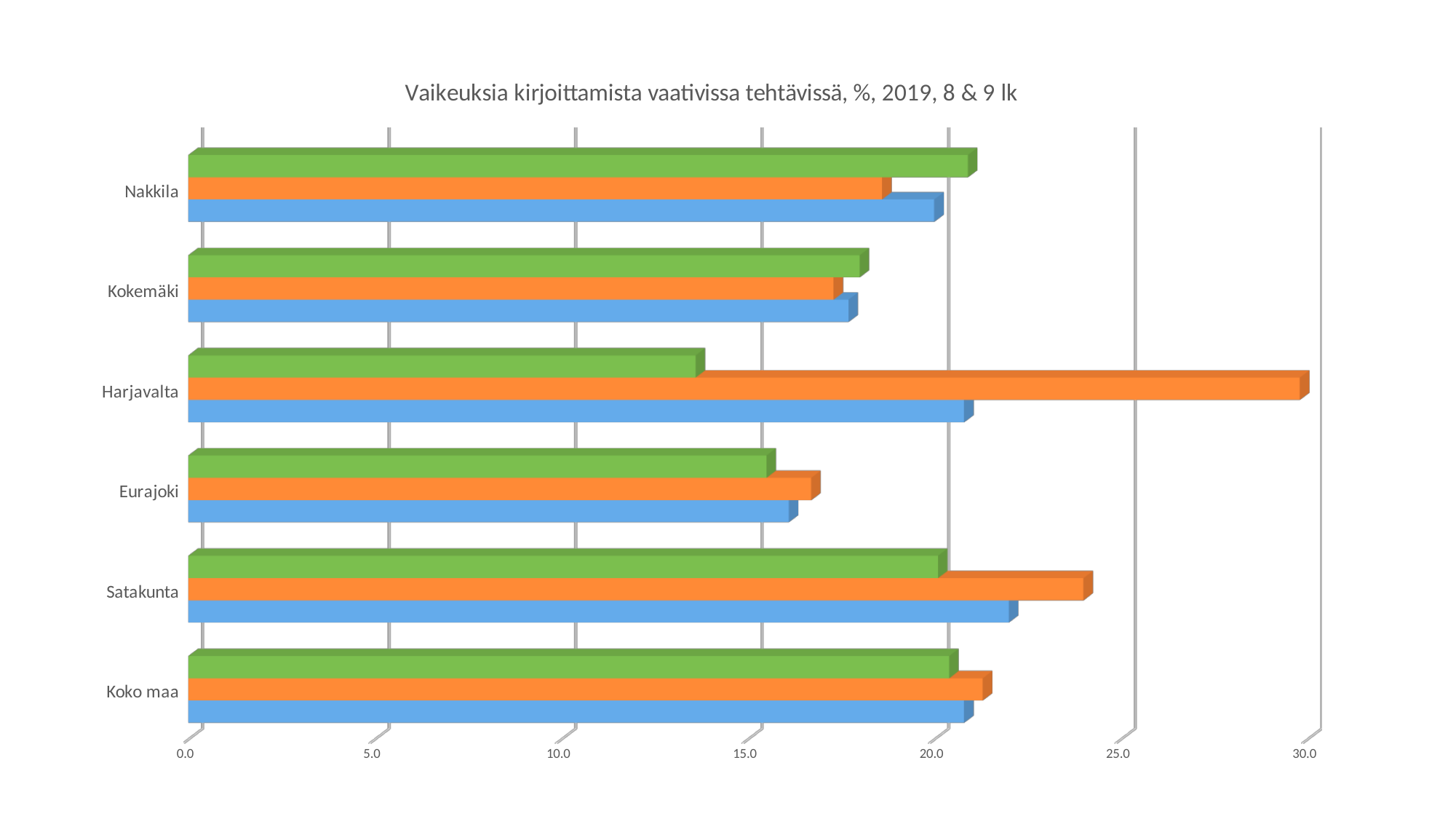
Which category has the shortest green bar? Harjavalta Is the green bar for Harjavalta greater or less than 15.0? less Which category has the shortest blue bar? Eurajoki What is the title of the chart? Vaikeuksia kirjoittamista vaativissa tehtävissä, %, 2019, 8 & 9 lk Is the orange bar for Harjavalta greater or less than 25.0? greater How many bars are plotted for each category in the chart? 3 Which category has the longest orange bar? Harjavalta How many categories are shown on the vertical axis of the chart? 6 Is the orange bar for Satakunta greater or less than 20.0? greater For Harjavalta, which is larger: the orange bar or the green bar? the orange bar What kind of chart is shown on the slide? bar chart